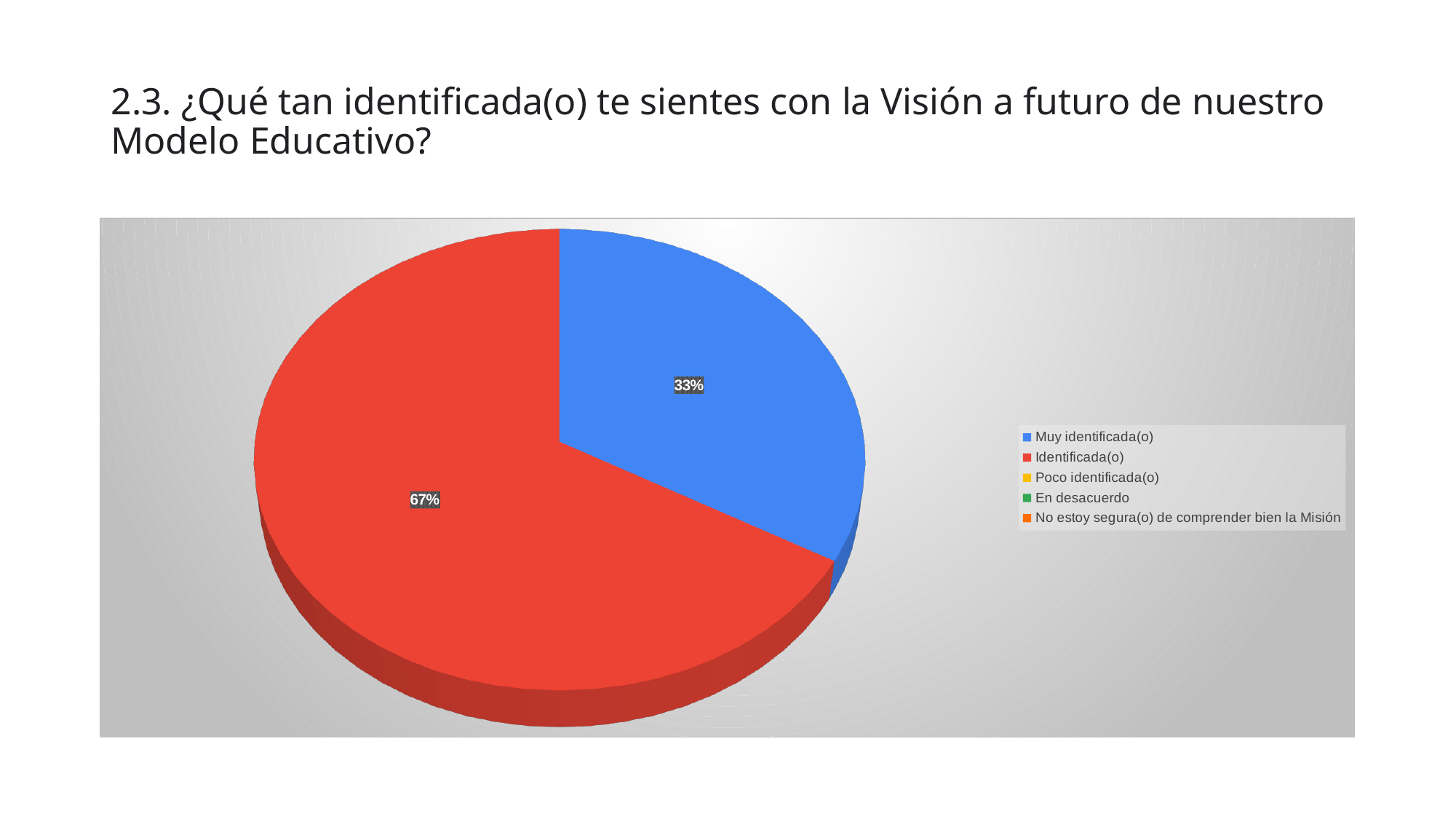
What is the difference in percentage points between the "Identificada(o)" slice and the "Muy identificada(o)" slice? 34% Is the share for "Identificada(o)" greater or less than 50%? greater What share of the pie does "Identificada(o)" represent? 67% What colour is the "Muy identificada(o)" slice? Blue How many slices are visible in the pie? 2 Which legend entry is shown in red? Identificada(o) What kind of chart is shown on the slide? Pie chart How many entries does the legend list? 5 Which category has the largest slice of the pie? Identificada(o) What share of the pie does "Muy identificada(o)" represent? 33% Which of the two visible slices is larger, "Muy identificada(o)" or "Identificada(o)"? Identificada(o)